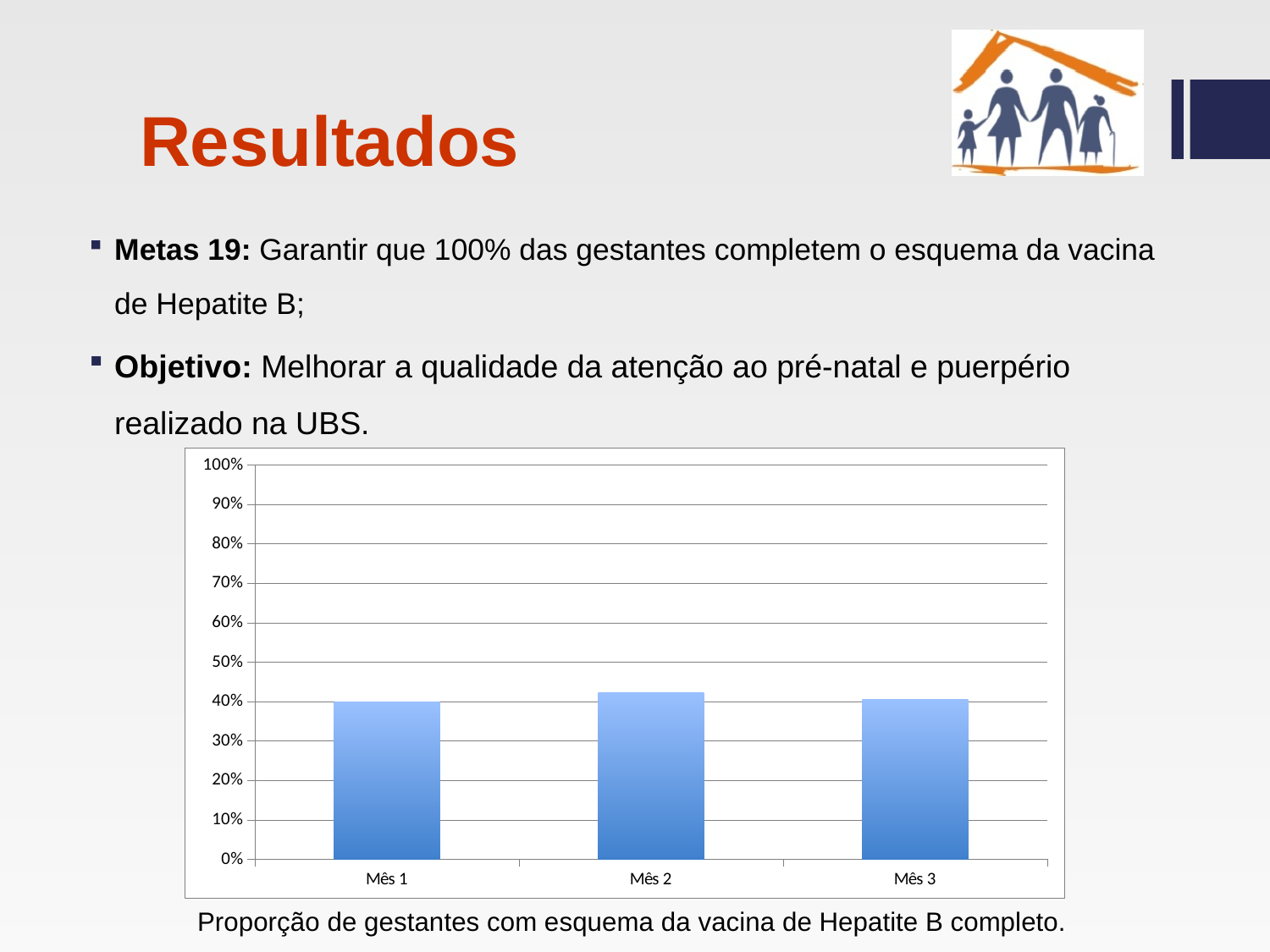
What is the highest value shown on the chart's vertical axis? 100% What kind of chart is shown on the slide? bar chart Is the value for Mês 2 greater or less than 30%? greater Which is larger, the value for Mês 1 or the value for Mês 2? Mês 2 Is the value for Mês 3 greater or less than 30%? greater Does the value rise or fall from Mês 2 to Mês 3? fall How many months (categories) are plotted on the chart? 3 What caption is written below the chart? Proporção de gestantes com esquema da vacina de Hepatite B completo. Is the value for Mês 1 greater or less than 50%? less Does the value rise or fall from Mês 1 to Mês 2? rise Which month has the highest proportion of pregnant women with a complete Hepatitis B vaccine schedule? Mês 2